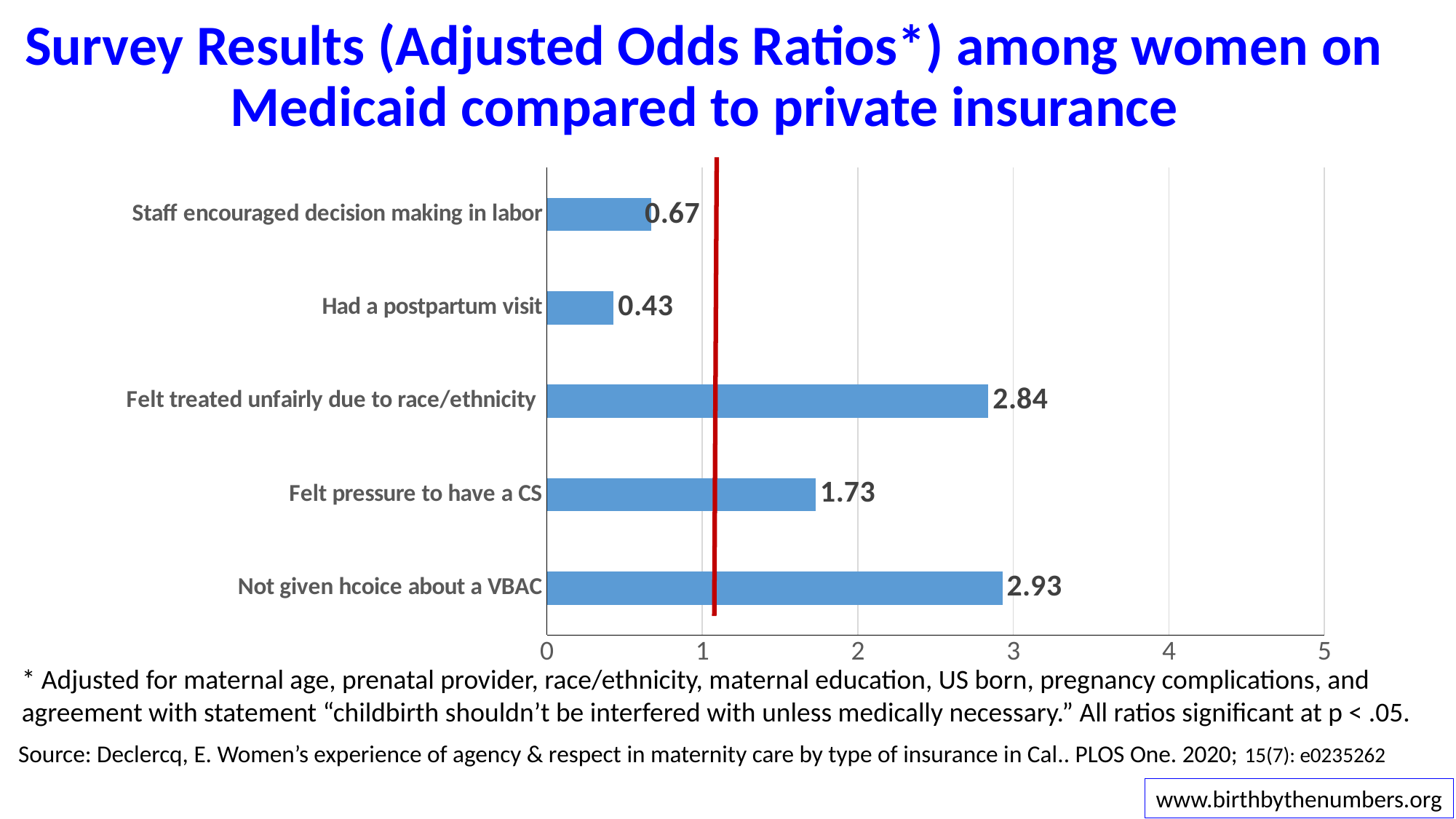
What is the adjusted odds ratio for "Had a postpartum visit"? 0.43 Which category has the lowest adjusted odds ratio? Had a postpartum visit What is the maximum value shown on the horizontal axis? 5 What is the adjusted odds ratio for "Felt pressure to have a CS"? 1.73 What is the difference between the odds ratios for "Felt treated unfairly due to race/ethnicity" and "Felt pressure to have a CS"? 1.11 What colour are the bars in the chart? Blue What is the adjusted odds ratio for "Staff encouraged decision making in labor"? 0.67 How many categories are plotted in the chart? 5 Which is larger: the odds ratio for "Felt pressure to have a CS" or for "Staff encouraged decision making in labor"? Felt pressure to have a CS Is the value for "Felt treated unfairly due to race/ethnicity" greater or less than 2? greater Which category has the highest adjusted odds ratio? Not given hcoice about a VBAC What kind of chart is shown on the slide? Bar chart